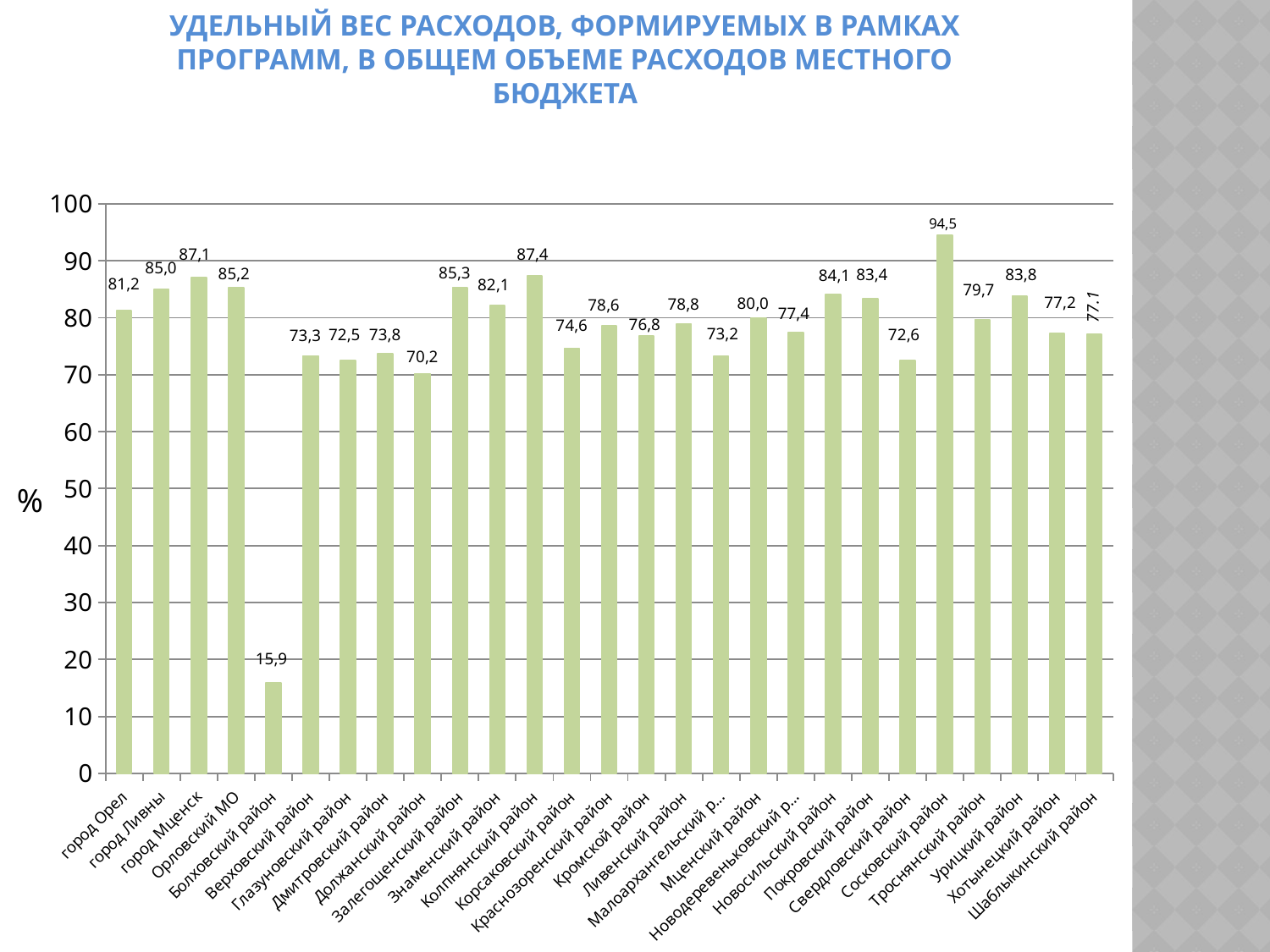
Which is larger, the value for Новосильский район or the value for Свердловский район? Новосильский район What is the difference between the values for город Ливны and город Орел? 3,8 What unit is shown on the vertical axis label? % How many categories are shown on the x axis? 27 What is the difference between the values for Сосковский район and Болховский район? 78,6 What kind of chart is shown on the slide? Bar chart What is the value for Мценский район? 80,0 Which category has the highest value? Сосковский район Which category has the lowest value? Болховский район What is the value for Должанский район? 70,2 What is the value for город Орел? 81,2 What is the value for Сосковский район? 94,5